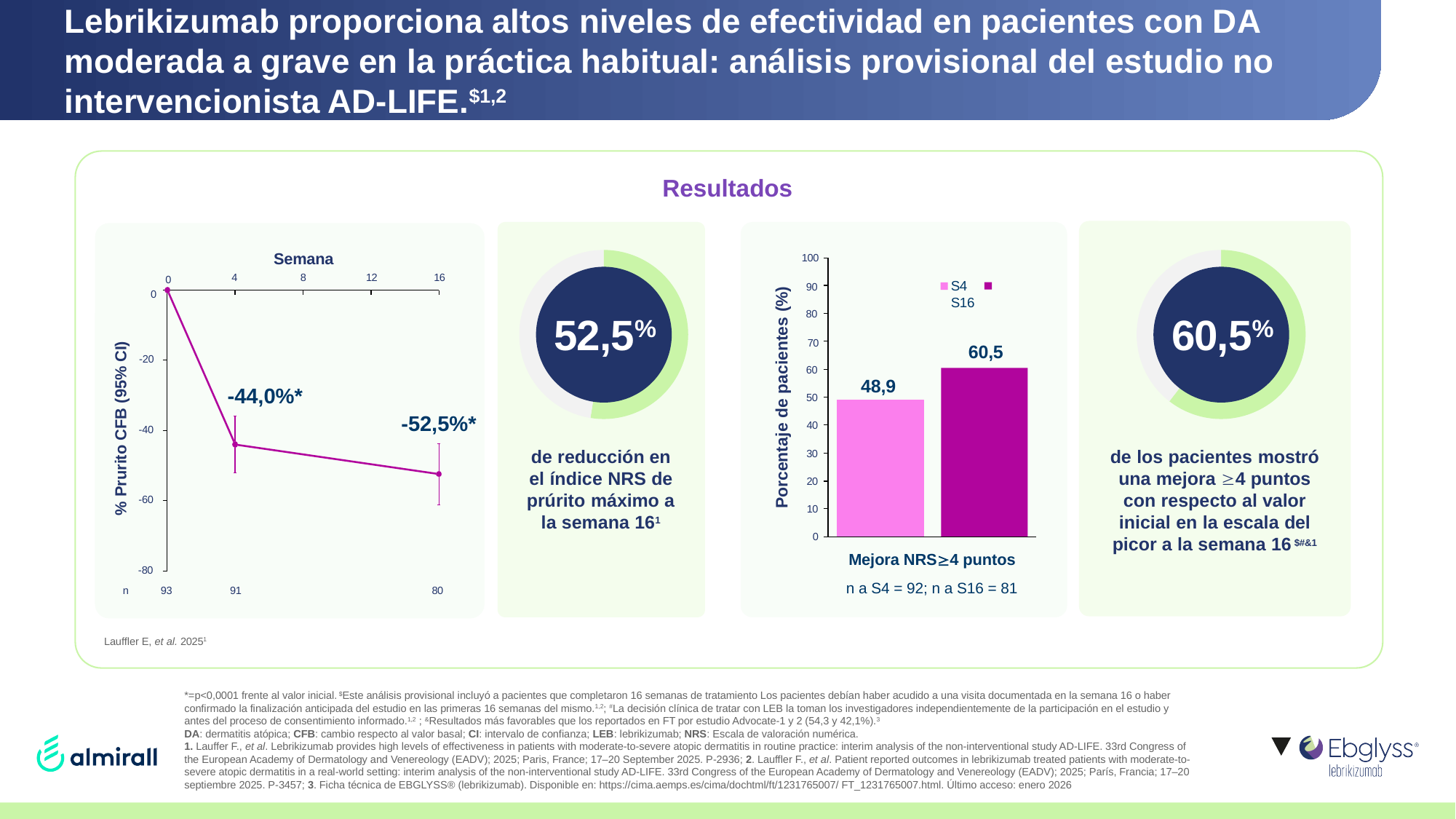
In the bar chart on the right, what is the value for S4? 48,9 In the bar chart on the right, what is the value for S16? 60,5 In the line chart on the left, what is the labelled value at week 4? -44,0%* In the bar chart on the right, what is the difference between the S16 and S4 values? 11,6 In the bar chart on the right, which is larger, S4 or S16? S16 In the bar chart on the right, is the value for S4 greater or less than 40? greater In the line chart on the left, how many data points are plotted? 3 In the line chart on the left, do the values rise or fall from week 0 to week 16? fall What kind of chart is the chart on the right showing 'Mejora NRS≥4 puntos'? bar chart How many series does the legend of the bar chart on the right list? 2 What is the y-axis label of the line chart on the left? % Prurito CFB (95% CI) In the line chart on the left, what is the labelled value at week 16? -52,5%*